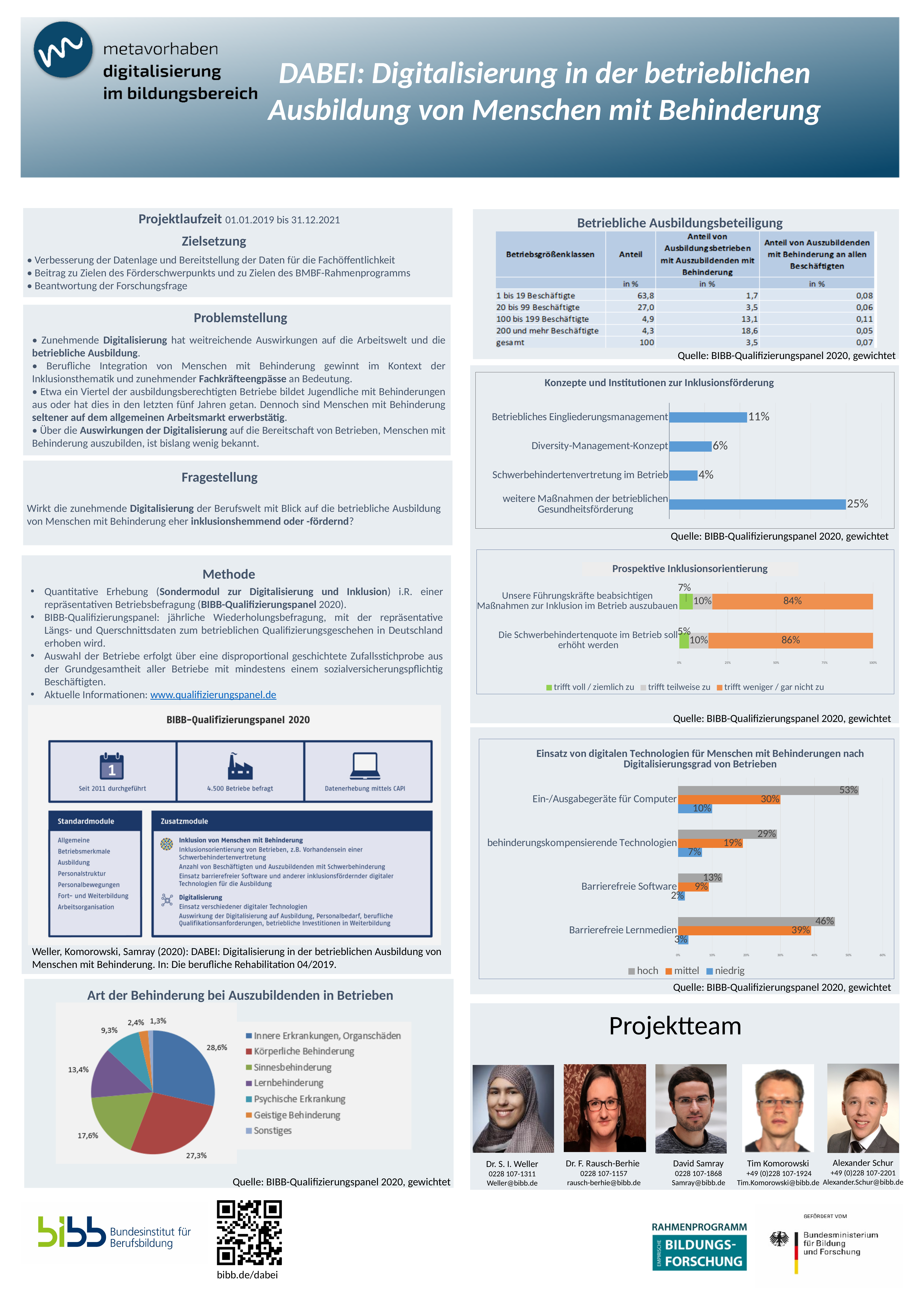
In the pie chart 'Art der Behinderung bei Auszubildenden in Betrieben', what is the share for Sinnesbehinderung? 17,6% How many slices does the pie chart 'Art der Behinderung bei Auszubildenden in Betrieben' have? 7 In the chart 'Einsatz von digitalen Technologien für Menschen mit Behinderungen nach Digitalisierungsgrad von Betrieben', which is larger for Barrierefreie Lernmedien: 'hoch' or 'mittel'? hoch What kind of chart is 'Art der Behinderung bei Auszubildenden in Betrieben'? pie chart In the chart 'Konzepte und Institutionen zur Inklusionsförderung', what is the value for Betriebliches Eingliederungsmanagement? 11% In the chart 'Konzepte und Institutionen zur Inklusionsförderung', which category has the lowest value? Schwerbehindertenvertretung im Betrieb How many series does the legend of the chart 'Prospektive Inklusionsorientierung' list? 3 In the chart 'Einsatz von digitalen Technologien für Menschen mit Behinderungen nach Digitalisierungsgrad von Betrieben', what is the difference between 'hoch' and 'niedrig' for behinderungskompensierende Technologien? 22% In the chart 'Prospektive Inklusionsorientierung', what share of respondents answered 'trifft weniger / gar nicht zu' for 'Die Schwerbehindertenquote im Betrieb soll erhöht werden'? 86% In the chart 'Einsatz von digitalen Technologien für Menschen mit Behinderungen nach Digitalisierungsgrad von Betrieben', what is the value for 'hoch' for Ein-/Ausgabegeräte für Computer? 53% In the chart 'Konzepte und Institutionen zur Inklusionsförderung', which category has the highest value? weitere Maßnahmen der betrieblichen Gesundheitsförderung In the chart 'Konzepte und Institutionen zur Inklusionsförderung', what is the difference between Betriebliches Eingliederungsmanagement and Diversity-Management-Konzept? 5%